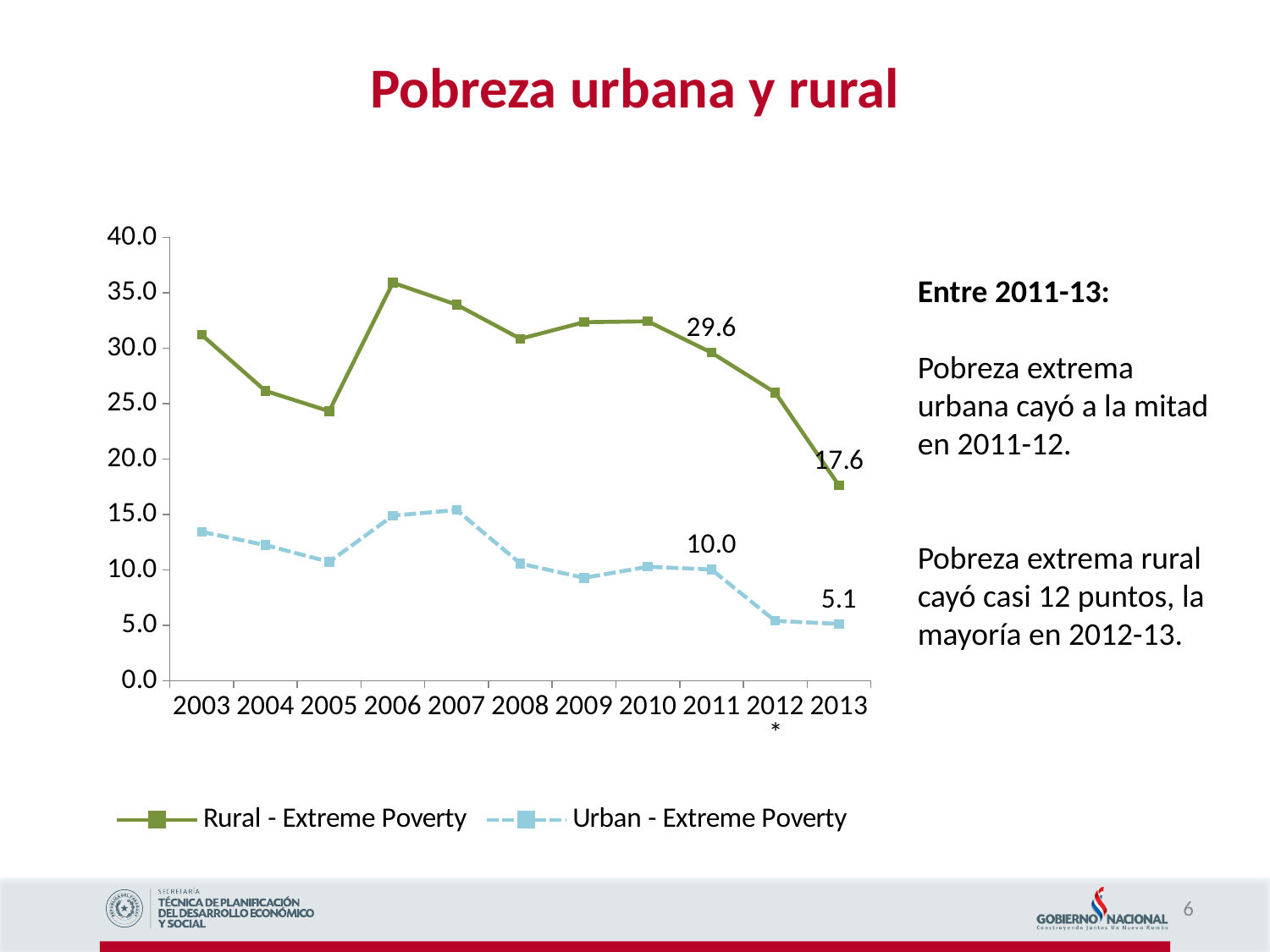
What is the value for Rural - Extreme Poverty in 2013? 17.6 What is the value for Urban - Extreme Poverty in 2011? 10.0 In which year is Rural - Extreme Poverty lowest? 2013 What kind of chart is shown on the slide? Line chart What is the value for Rural - Extreme Poverty in 2011? 29.6 Is the value for Urban - Extreme Poverty in 2012 greater or less than 10.0? less Is the value for Rural - Extreme Poverty in 2003 greater or less than 30.0? greater What is the difference between the Rural and Urban extreme poverty values in 2013? 12.5 What is the value for Urban - Extreme Poverty in 2013? 5.1 How many years are shown on the x axis of the chart? 11 By how much did Rural - Extreme Poverty fall between 2011 and 2013? 12.0 In which year is Rural - Extreme Poverty highest? 2006